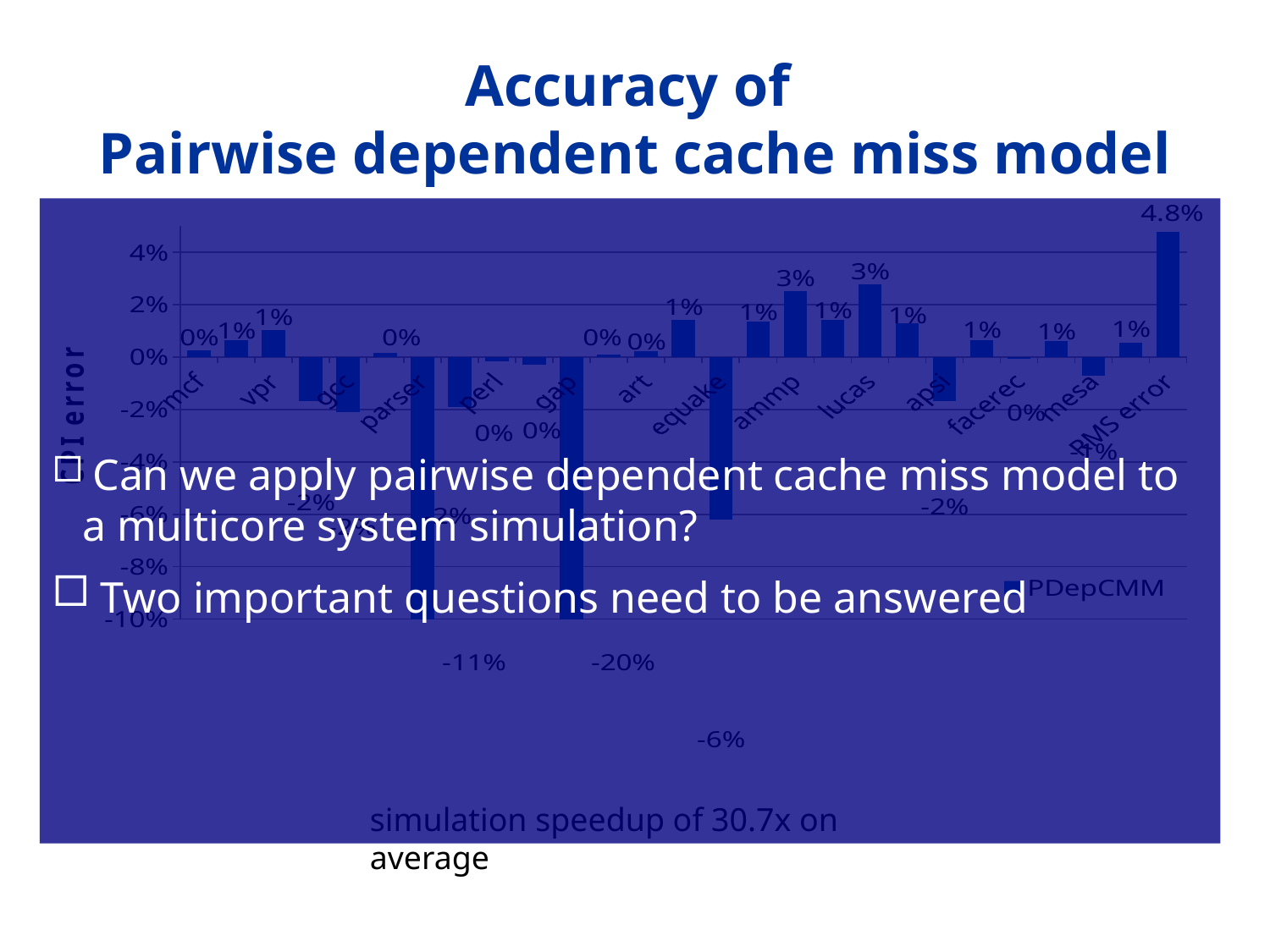
What is the difference between the RMS error value (4.8%) and the ammp value (3%)? 1.8% How many series does the chart legend list? 1 What kind of chart is shown on the slide? bar chart What is the value of the RMS error bar? 4.8% Which category has the lowest value in the chart? gap What is the value for equake? -6% What is the lowest data label value shown in the chart? -20% Which category has the highest value in the chart? RMS error What is the value for parser? -11% Is the value for equake greater or less than -4%? less What is the name of the series shown in the chart legend? PDepCMM Which is larger, the value for ammp or the value for mcf? ammp